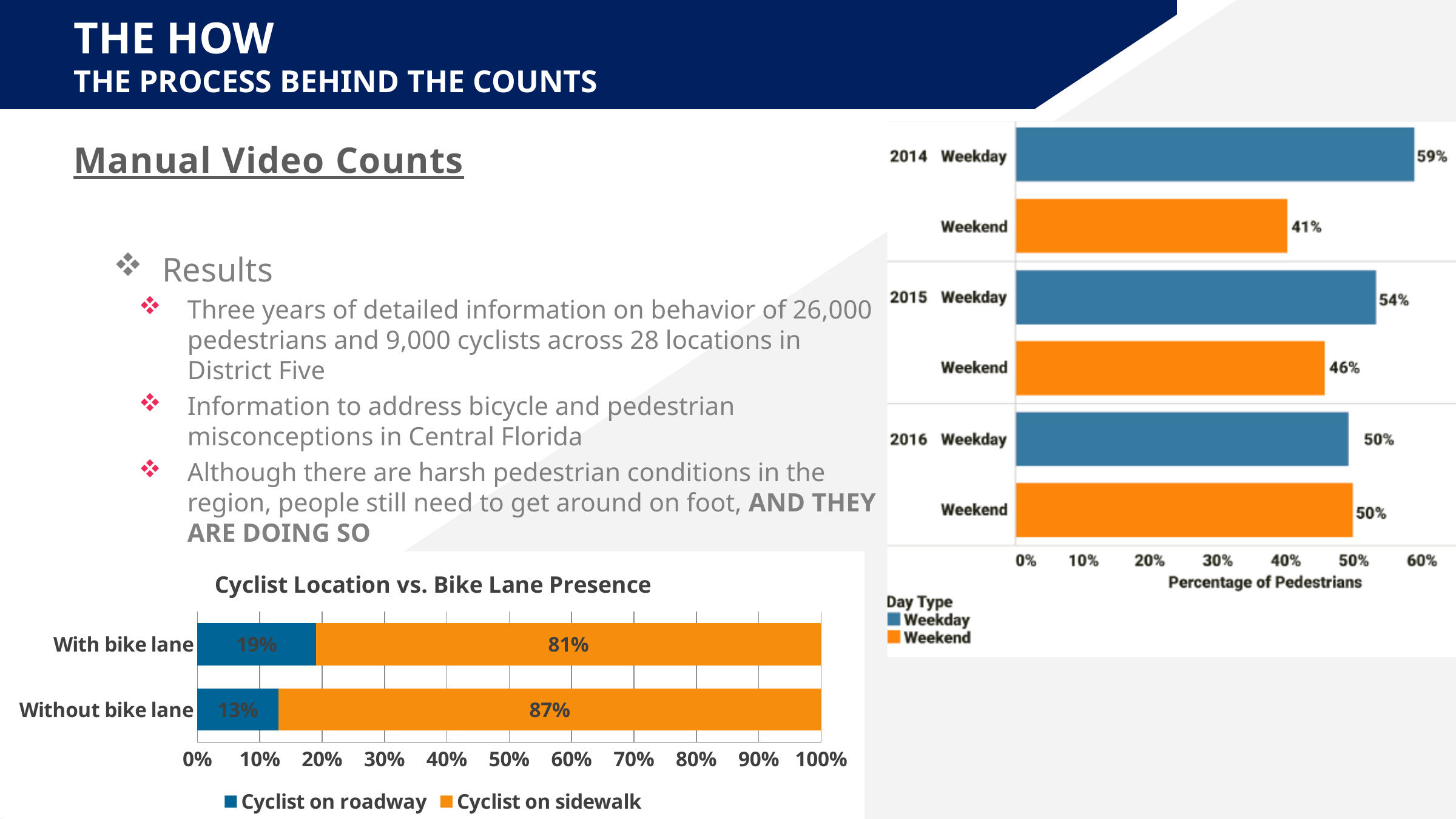
In the chart on the right showing Percentage of Pedestrians, what is the value for 2014 Weekday? 59% In the 'Cyclist Location vs. Bike Lane Presence' chart, what percentage of cyclists are on the roadway with a bike lane? 19% In the 'Cyclist Location vs. Bike Lane Presence' chart, what is the total of the stacked bar for 'With bike lane'? 100% In the 'Cyclist Location vs. Bike Lane Presence' chart, how many series does the legend list? 2 In the chart on the right showing Percentage of Pedestrians, what is the value for 2015 Weekend? 46% In the chart on the right showing Percentage of Pedestrians, what is the difference between the 2014 Weekday and 2014 Weekend values? 18% What kind of chart is 'Cyclist Location vs. Bike Lane Presence'? Stacked bar chart In the chart on the right showing Percentage of Pedestrians, which bar has the lowest value? 2014 Weekend In the chart on the right showing Percentage of Pedestrians, which colour represents Weekend in the Day Type legend? Orange In the 'Cyclist Location vs. Bike Lane Presence' chart, what percentage of cyclists are on the sidewalk without a bike lane? 87% In the 'Cyclist Location vs. Bike Lane Presence' chart, what is the difference between the 'Cyclist on sidewalk' values for 'Without bike lane' and 'With bike lane'? 6% In the chart on the right showing Percentage of Pedestrians, do the Weekday values rise or fall from 2014 to 2016? Fall